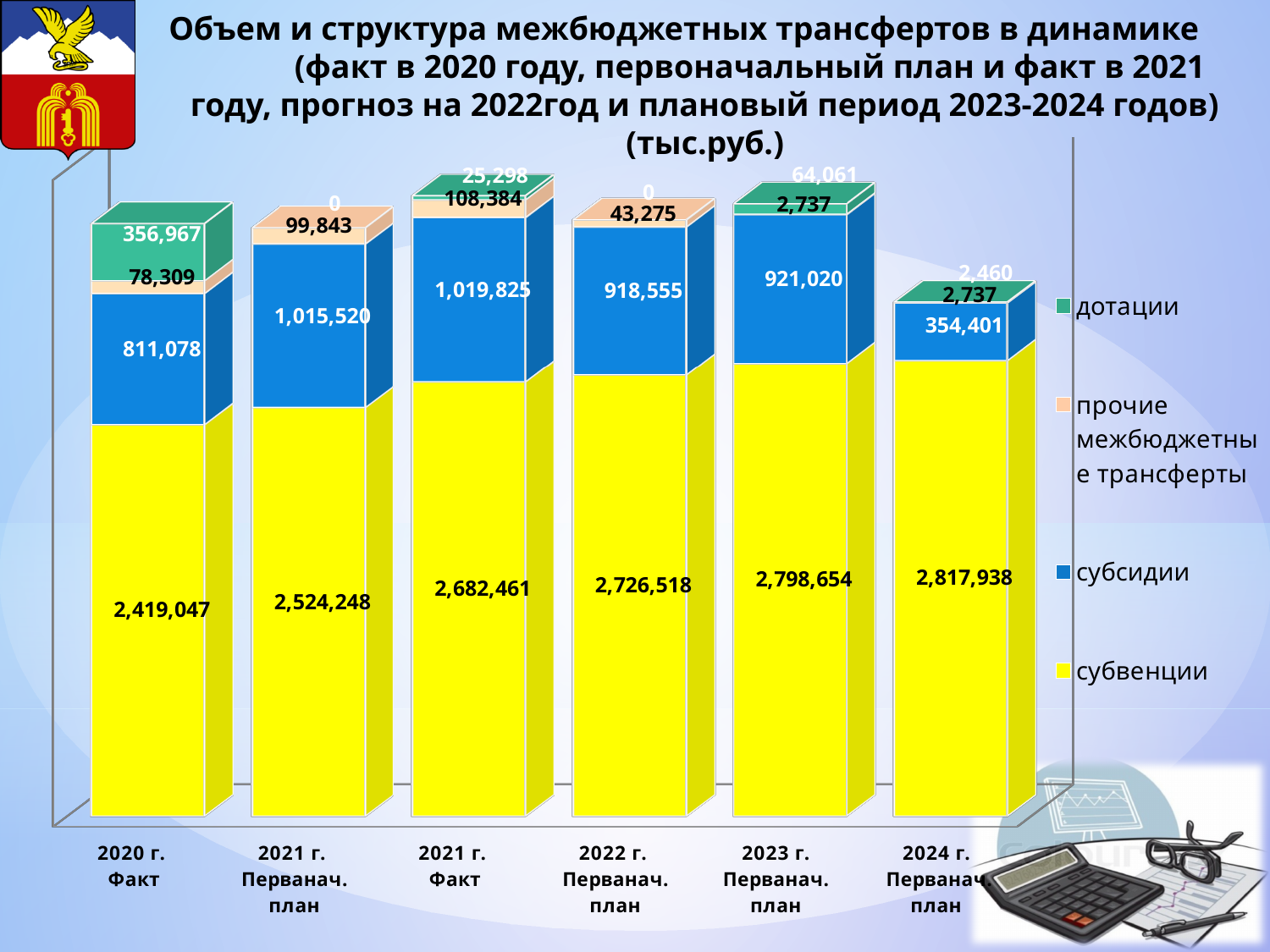
What is the value of дотации for 2020 г. Факт? 356,967 What kind of chart is shown on the slide? Stacked bar chart How many series does the legend list? 4 Do the values of субвенции rise or fall from 2020 г. Факт to 2024 г. Первонач. план? Rise Which category has the highest value of субвенции? 2024 г. Первонач. план What is the value of субсидии for 2021 г. Первонач. план? 1,015,520 Which is larger: субвенции for 2022 г. Первонач. план or for 2021 г. Факт? 2022 г. Первонач. план What is the difference between субсидии for 2021 г. Факт and 2021 г. Первонач. план? 4,305 What is the value of субвенции for 2020 г. Факт? 2,419,047 How many bars (categories) are shown on the chart? 6 Which category has the lowest value of субсидии? 2024 г. Первонач. план What is the value of прочие межбюджетные трансферты for 2022 г. Первонач. план? 43,275